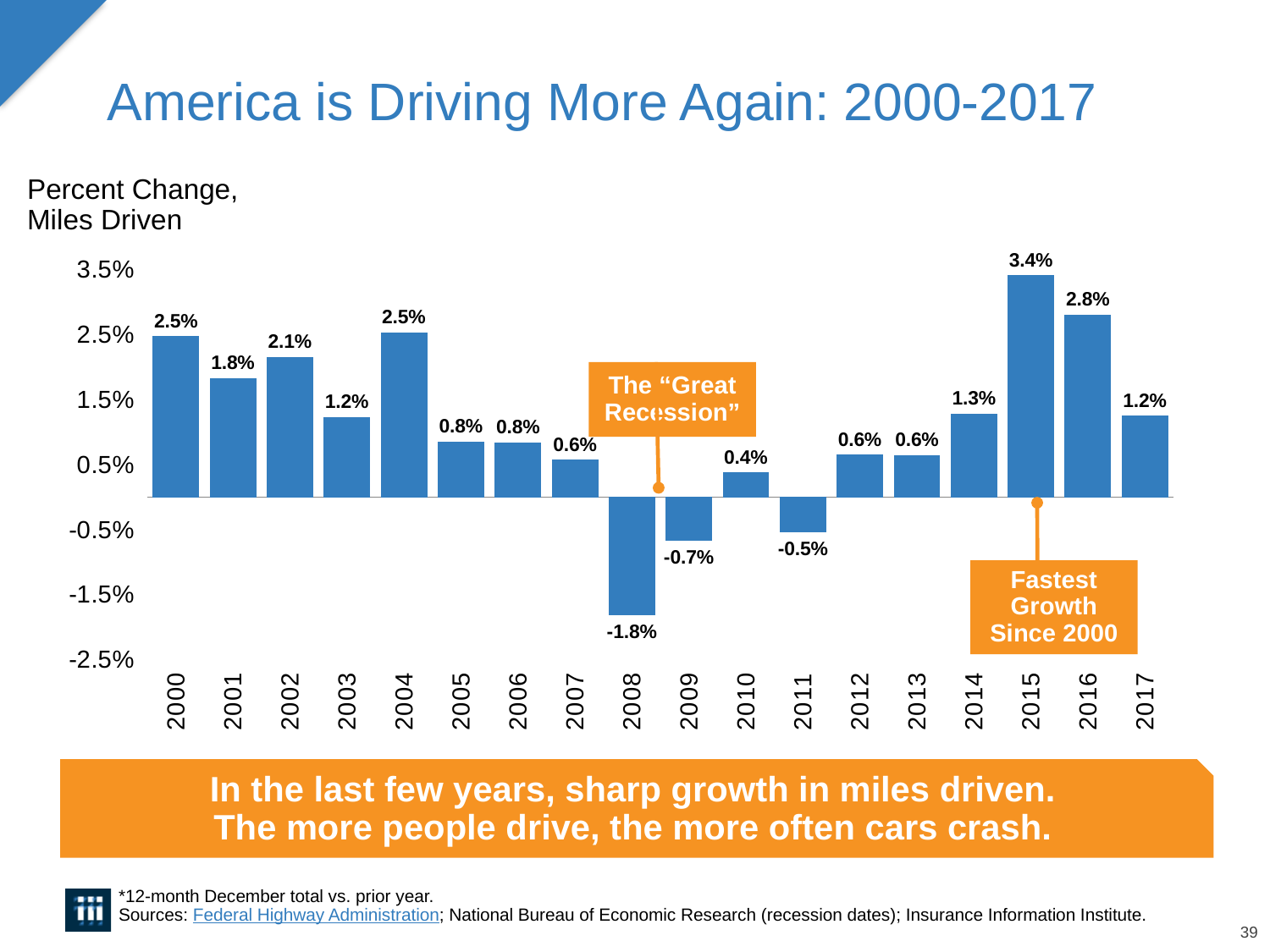
What is the percent change in miles driven for 2017? 1.2% What kind of chart is shown on the slide? Bar chart Which year has a larger percent change in miles driven, 2002 or 2014? 2002 Do the values rise or fall from 2014 to 2017? Rise then fall Which year has the highest percent change in miles driven? 2015 Which year has the lowest percent change in miles driven? 2008 What is the percent change in miles driven for 2015? 3.4% What is the difference between the percent change in 2015 and the percent change in 2016? 0.6% How many years are shown on the x axis of the chart? 18 Is the value for 2016 greater or less than 2.5%? greater What is the percent change in miles driven for 2008? -1.8% Which year is labelled on the chart as having the fastest growth since 2000? 2015